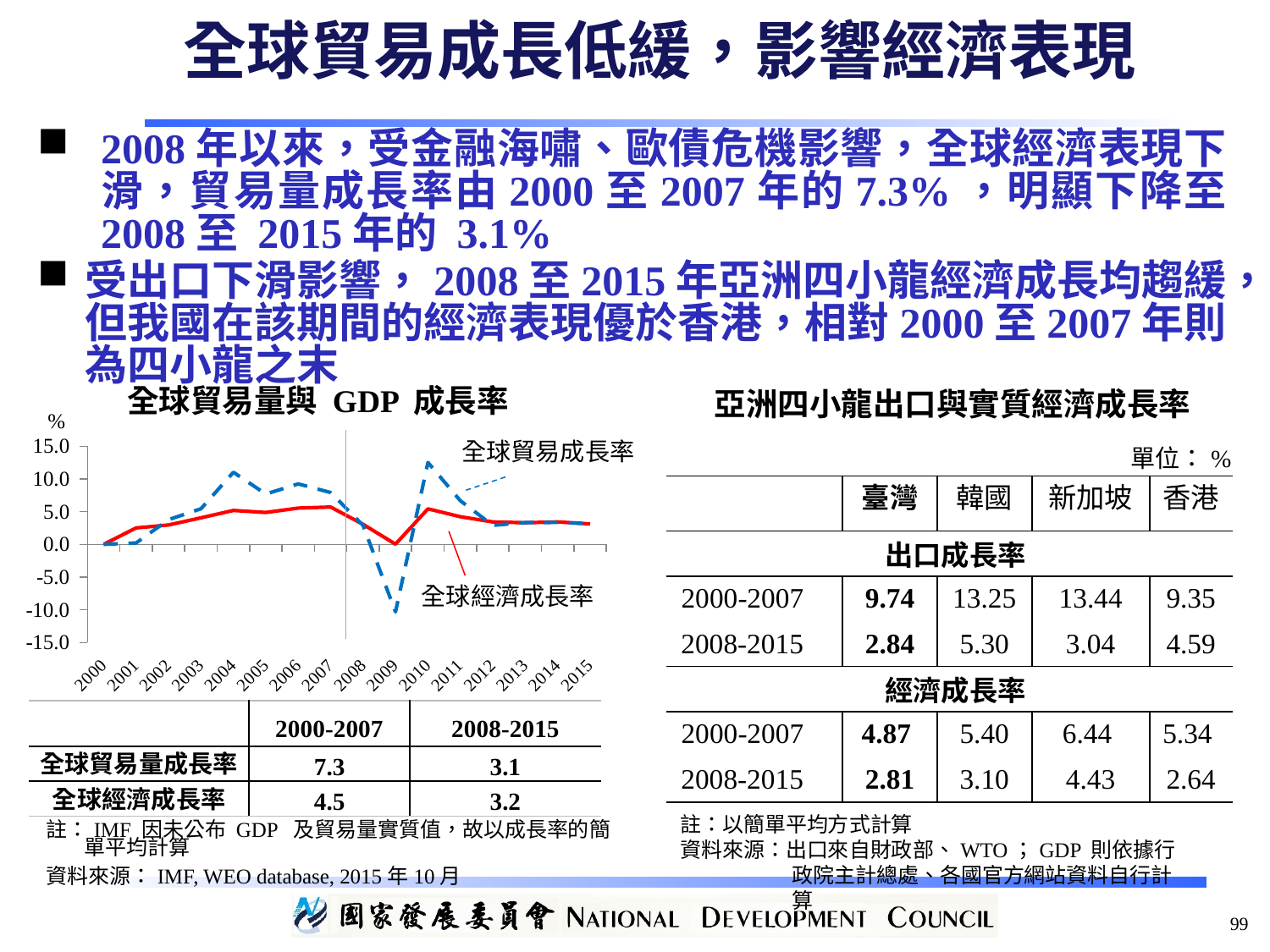
In the 全球貿易量與 GDP 成長率 chart, does 全球貿易成長率 rise or fall from 2010 to 2015? fall In the 全球貿易量與 GDP 成長率 chart, is the value for 全球貿易成長率 in 2009 greater or less than -5.0? less What is the title of the line chart on the slide? 全球貿易量與 GDP 成長率 In the 全球貿易量與 GDP 成長率 chart, which series has the higher value in 2009, 全球貿易成長率 or 全球經濟成長率? 全球經濟成長率 How many series are plotted in the 全球貿易量與 GDP 成長率 chart? 2 How many years are shown on the x axis of the 全球貿易量與 GDP 成長率 chart? 16 In the 全球貿易量與 GDP 成長率 chart, is the value for 全球經濟成長率 in 2001 greater or less than 0.0? greater In the 全球貿易量與 GDP 成長率 chart, which year has the lowest value for 全球貿易成長率? 2009 What kind of chart is the 全球貿易量與 GDP 成長率 chart? line chart In the 全球貿易量與 GDP 成長率 chart, is the value for 全球貿易成長率 in 2010 greater or less than 10.0? greater In the 全球貿易量與 GDP 成長率 chart, which series is drawn as a dashed line? 全球貿易成長率